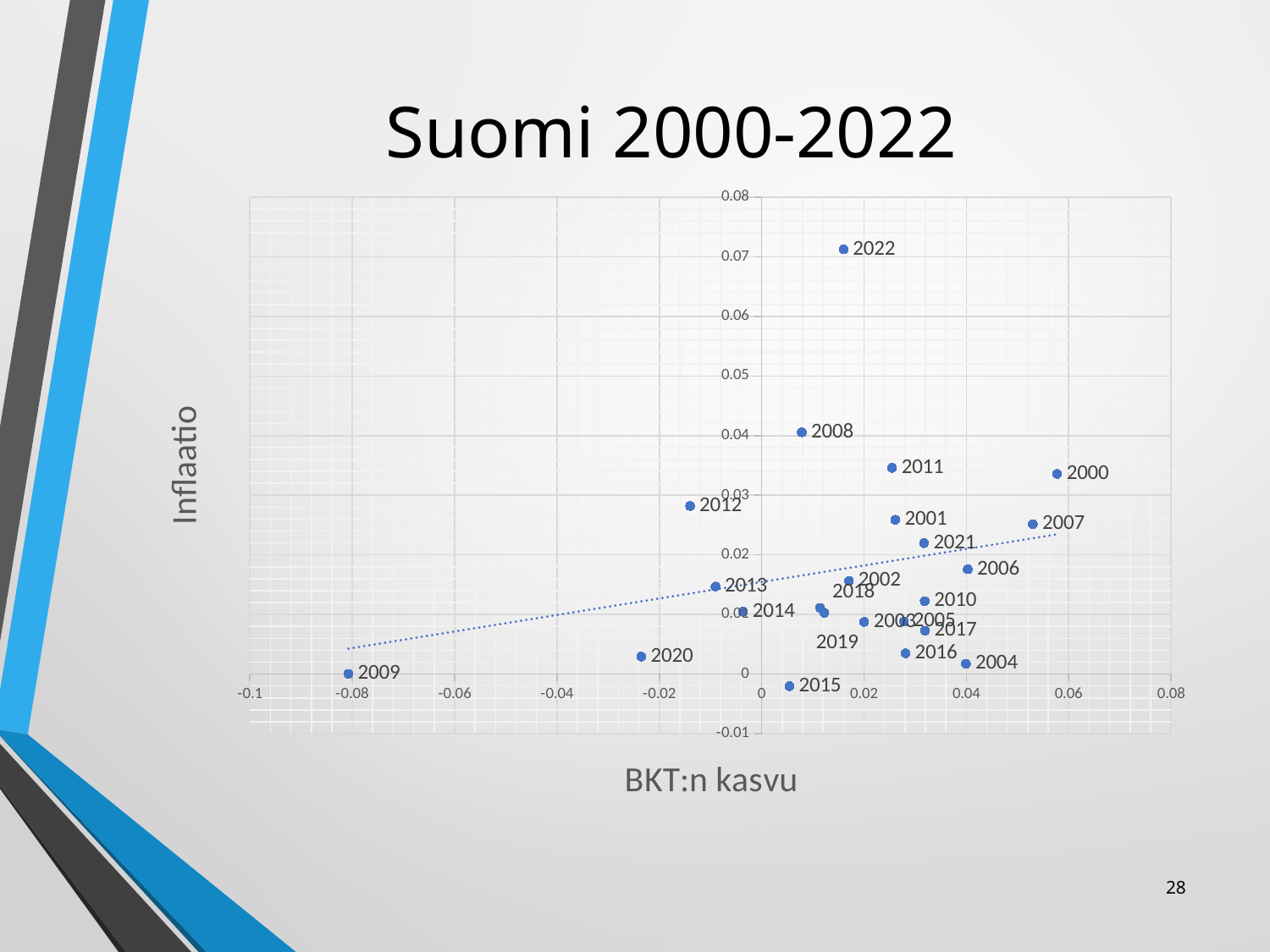
Is the inflation value for 2008 greater or less than 0.03? greater How many data points (years) are plotted on the chart? 23 What kind of chart is shown on the slide? scatter chart Which year has the lowest BKT:n kasvu (GDP growth) value on the chart? 2009 Which year has the highest inflation value on the chart? 2022 Is the inflation value for 2022 greater or less than 0.06? greater What is the title of the y axis? Inflaatio Which year has the higher inflation value, 2022 or 2008? 2022 Does the dotted trend line rise or fall as BKT:n kasvu increases? rises Which year has the highest BKT:n kasvu (GDP growth) value on the chart? 2000 Which year has the lowest inflation value on the chart? 2015 Is the BKT:n kasvu value for 2009 greater or less than -0.06? less